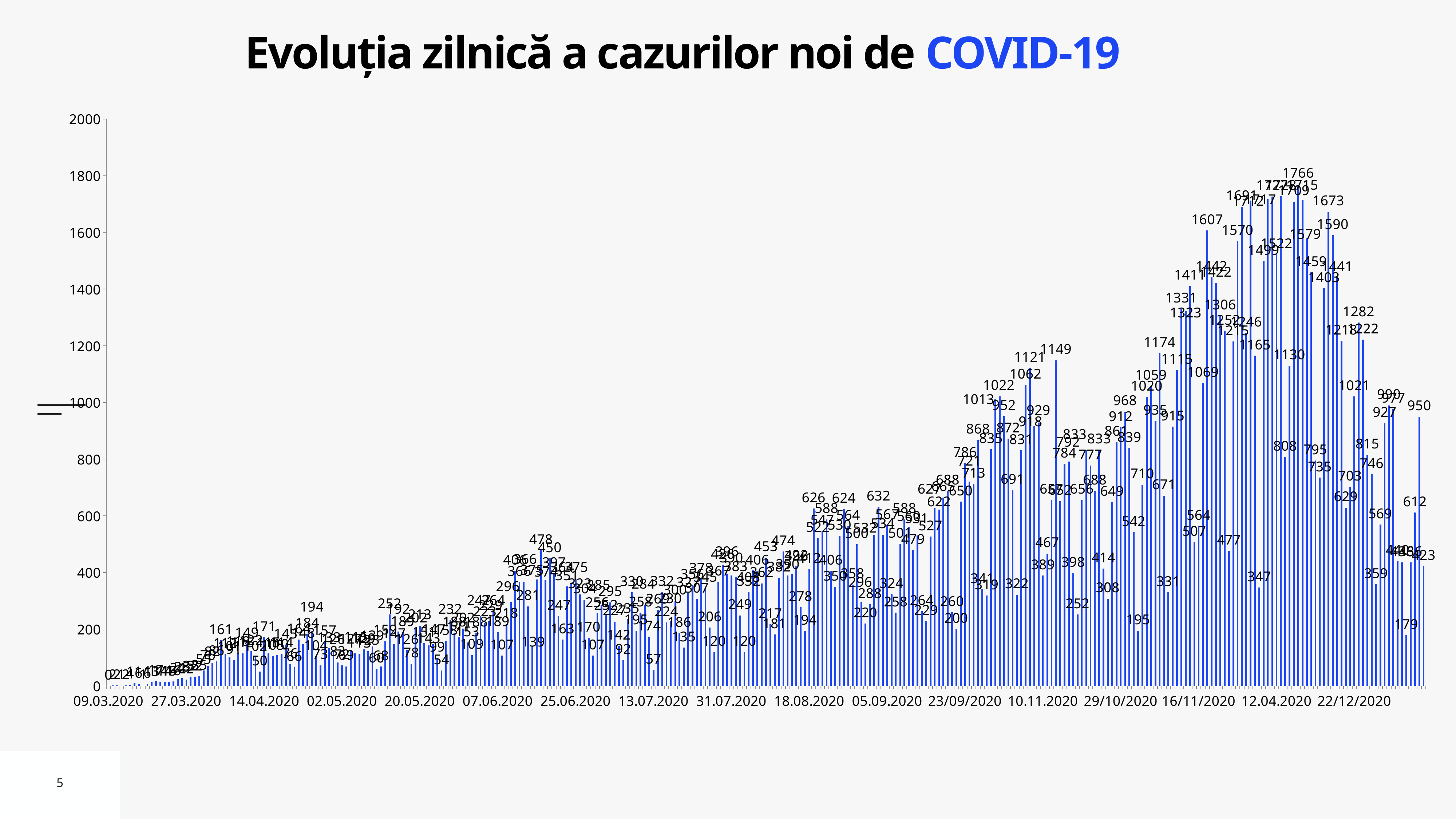
Is the highest bar on the chart greater or less than 1800? less What is the highest value shown on the vertical axis? 2000 What kind of chart is shown on the slide? bar chart What is the difference between the bars labelled 1766 and 1607? 159 Which is larger, the bar labelled 1766 or the bar labelled 1673? 1766 What is the difference between the bars labelled 1766 and 1673? 93 What is the title of the chart? Evoluția zilnică a cazurilor noi de COVID-19 What is the highest daily value labelled on the chart? 1766 What is the first date label on the horizontal axis? 09.03.2020 Is the highest bar on the chart greater or less than 1600? greater Overall, do the daily values rise or fall from March 2020 to December 2020? rise What is the last date label on the horizontal axis? 22/12/2020